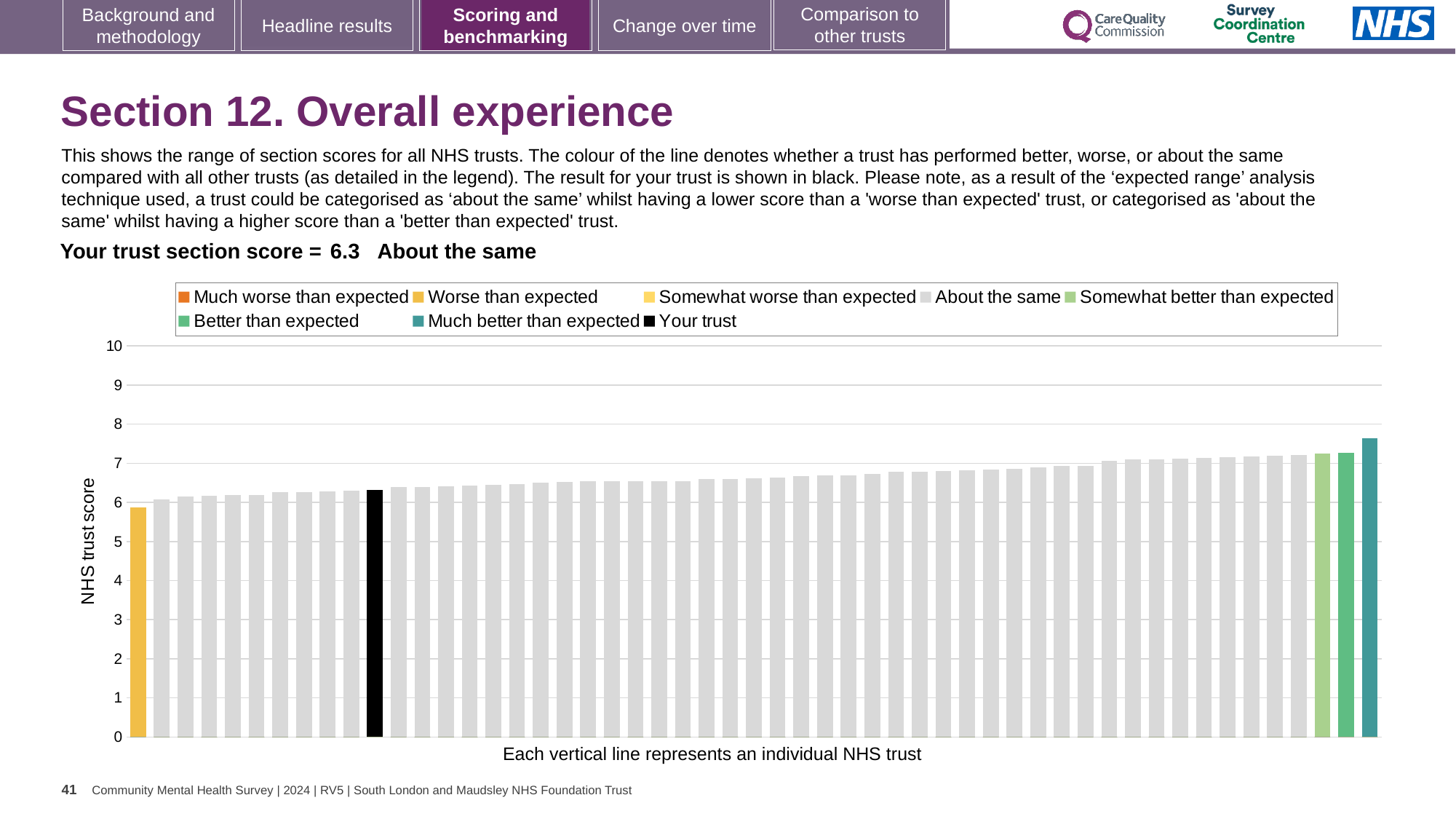
How many entries does the chart legend list? 8 Is the tallest bar in the chart greater or less than 8? less Is the shortest bar in the chart greater or less than 7? less What is the label on the vertical axis of the chart? NHS trust score Which legend category does the tallest bar belong to? Much better than expected Do the bar values rise or fall from left to right along the x axis? rise Is the score for your trust greater or less than 5? greater Which legend category does the shortest bar belong to? Worse than expected What is the section score for your trust? 6.3 Which legend category does your trust fall into for this section? About the same What kind of chart is shown on the slide? bar chart